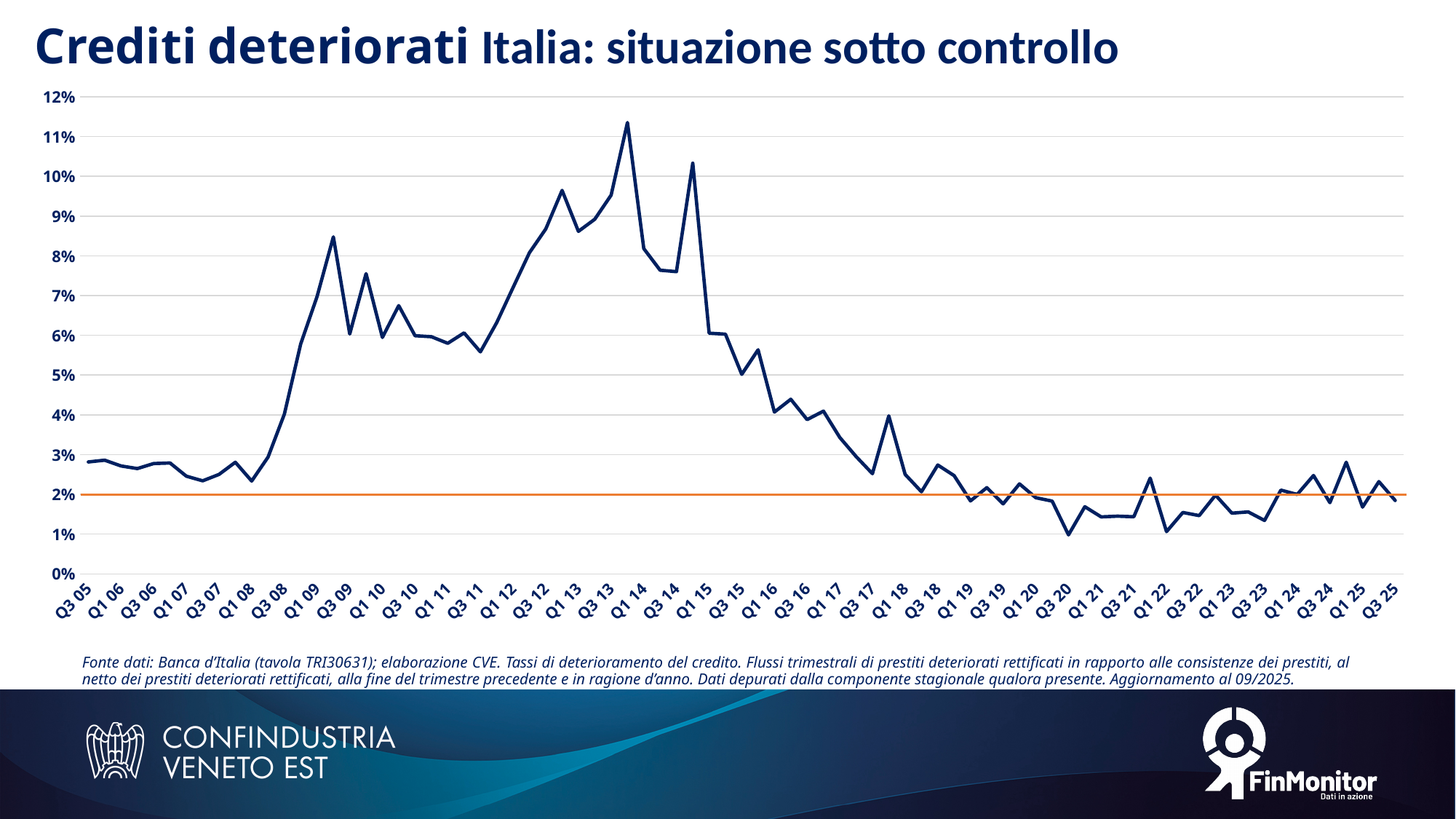
What is the highest value shown on the y axis? 12% Is the value for Q1 14 greater or less than 11%? less Which is larger, the value for Q1 14 or the value for Q1 15? Q1 14 How many quarter labels are shown on the x axis? 41 Is the value for Q3 05 greater or less than 2%? greater Is the value for Q3 09 greater or less than 8%? less What kind of chart is shown on the slide? line chart Does the line generally rise or fall between Q1 14 and Q3 20? fall At what level is the orange horizontal reference line drawn? 2% What is the title of the slide? Crediti deteriorati Italia: situazione sotto controllo